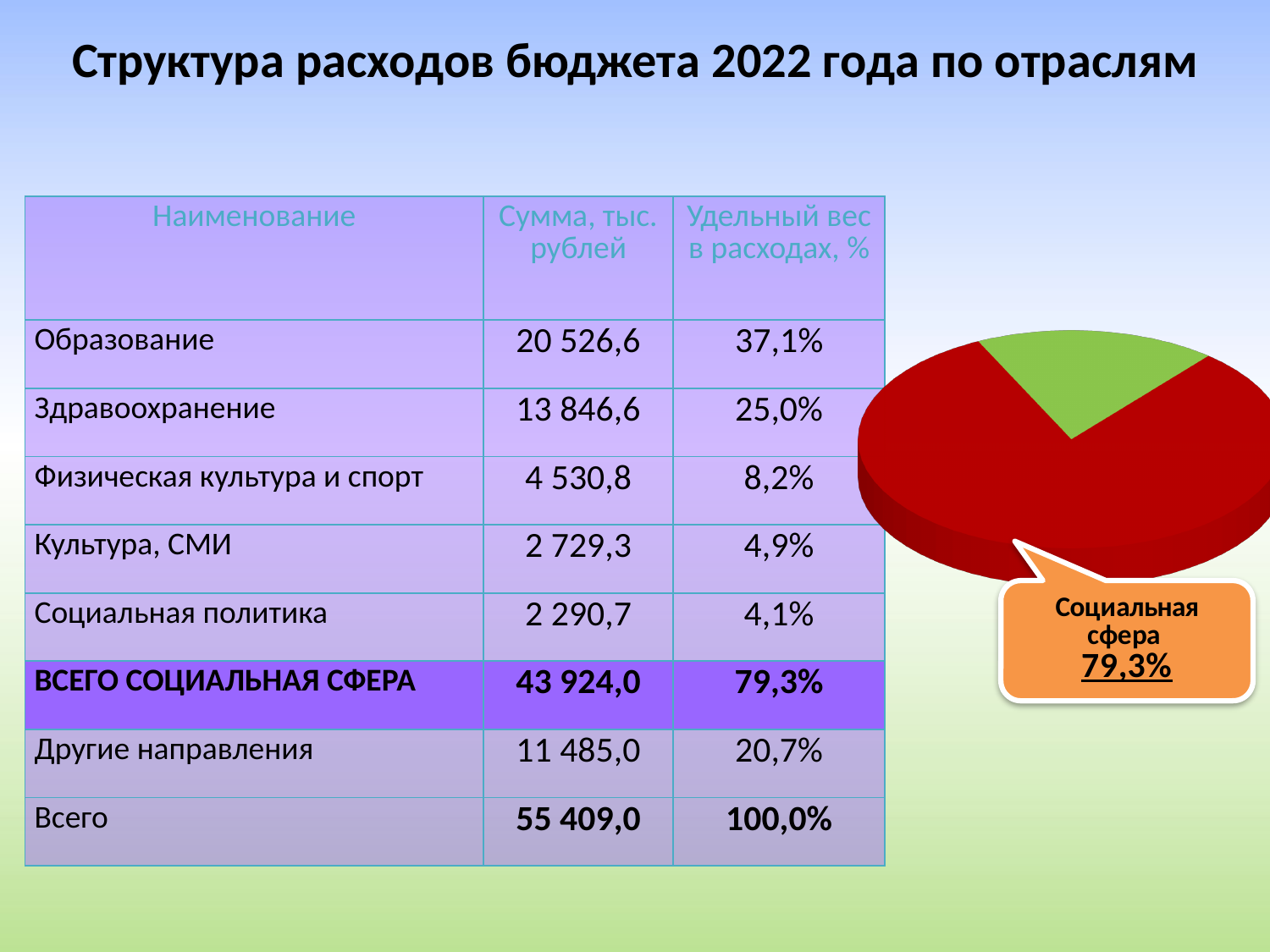
What kind of chart is shown on the slide? pie chart Which slice of the pie chart is larger, the red one or the green one? the red one What share of the pie does the green slice represent, given that Социальная сфера is 79,3% of 100,0%? 20,7% What colour is the smallest slice of the pie chart? green What share of the pie does the slice labelled Социальная сфера represent? 79,3% Which category has the largest slice in the pie chart? Социальная сфера What text is shown in the callout pointing to the pie chart? Социальная сфера 79,3% How many slices does the pie chart have? 2 Is the share of Социальная сфера in the pie chart greater or less than 50%? greater What colour is the slice for Социальная сфера in the pie chart? red